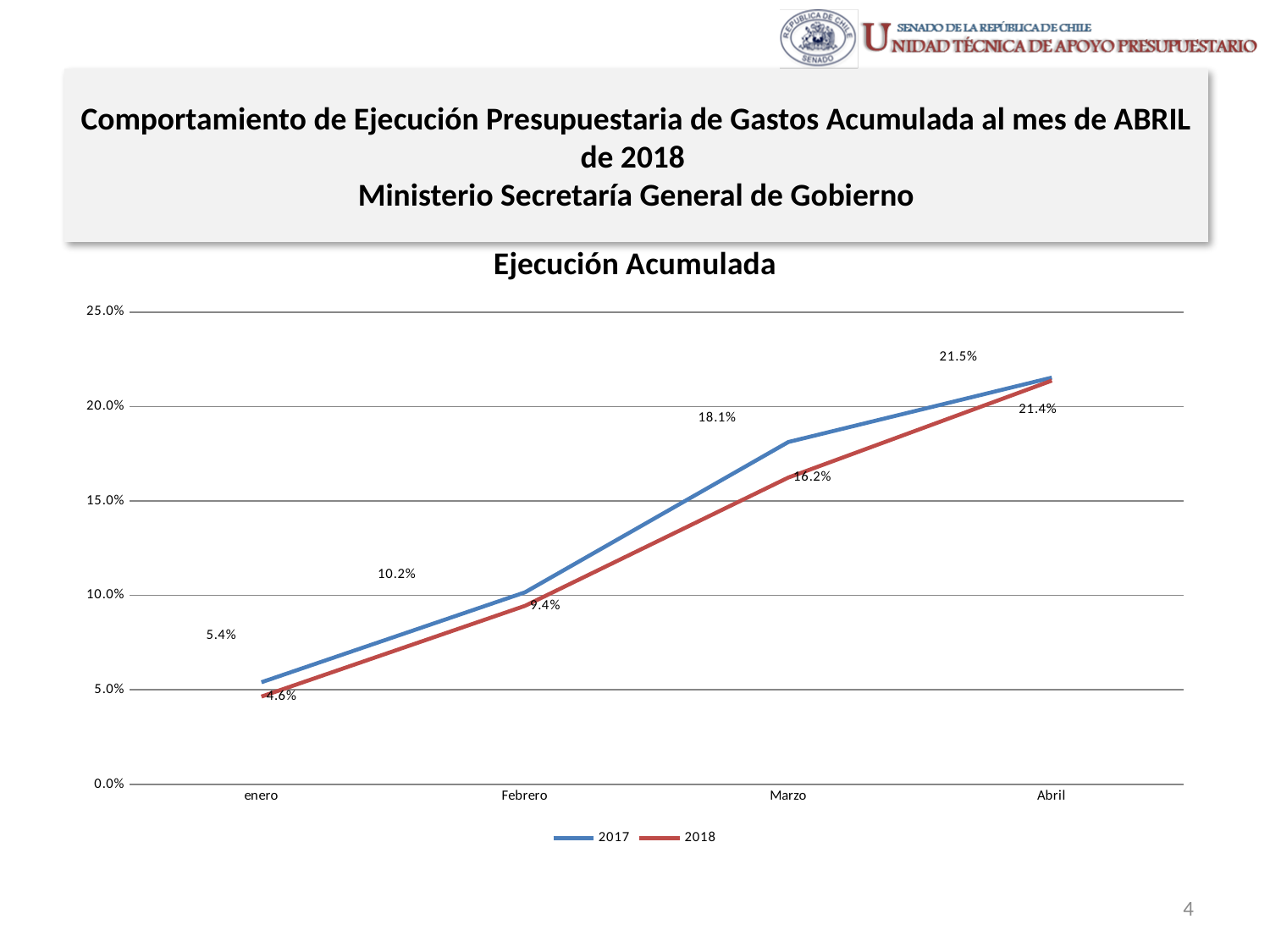
In which month is the 2018 series lowest? enero What is the value for 2017 in Febrero? 10.2% What is the value for 2017 in Marzo? 18.1% In which month is the 2017 series highest? Abril What is the title of the chart? Ejecución Acumulada Which series has the larger value in Febrero, 2017 or 2018? 2017 What is the value for 2018 in Abril? 21.4% How many series does the legend list? 2 How many months are shown on the x axis? 4 What is the difference between the 2017 and 2018 values in Marzo? 1.9% What kind of chart is shown on the slide? line chart What is the value for 2018 in enero? 4.6%